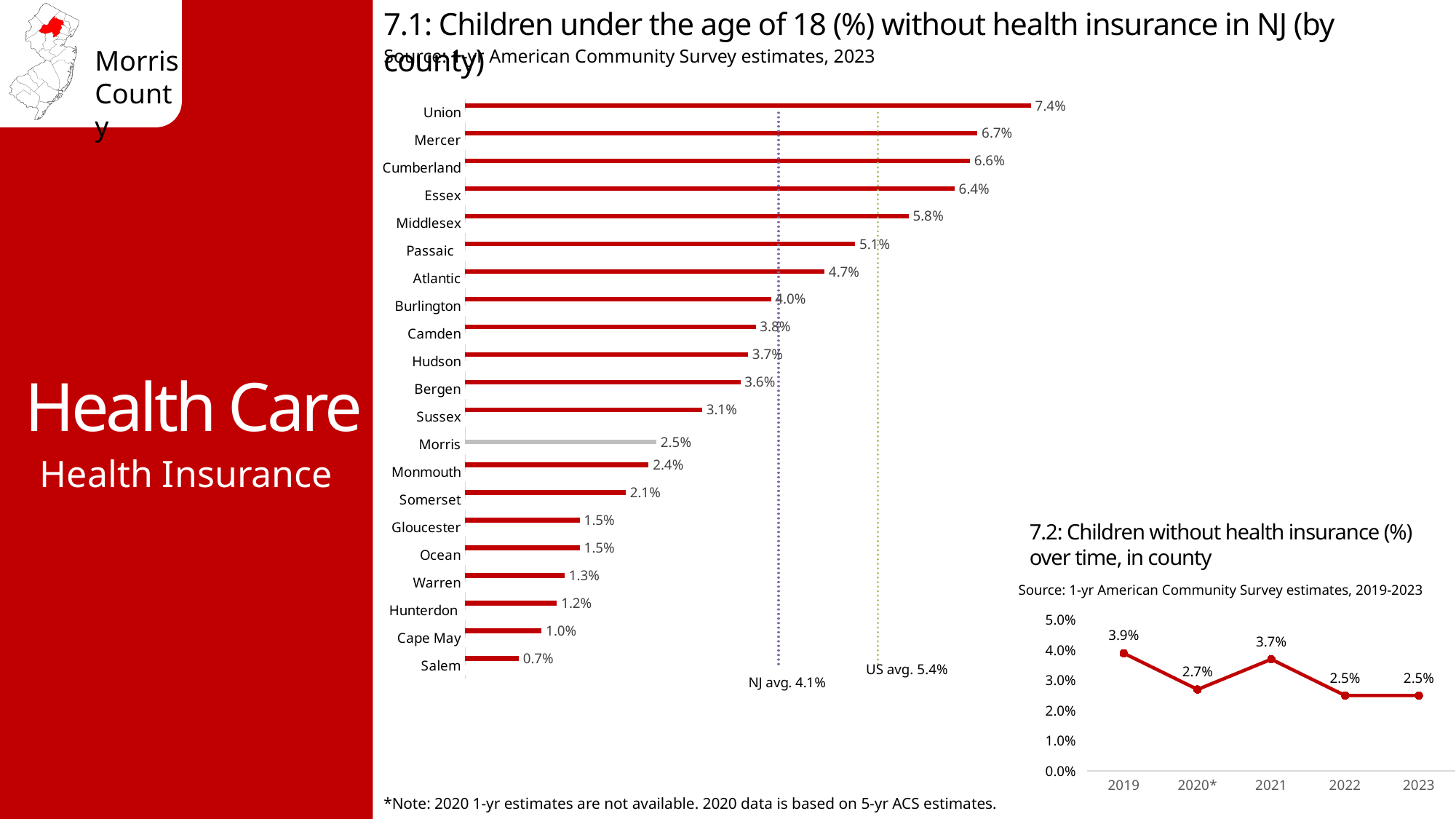
In chart 7.2, what is the difference between the values for 2019 and 2023? 1.4% In chart 7.1, which county has the lowest percentage of children without health insurance? Salem In chart 7.1, what is the difference between the values for Union and Salem? 6.7% In chart 7.1, how many counties are shown? 21 In chart 7.2, what is the value for 2021? 3.7% In chart 7.2, which year has the highest value? 2019 In chart 7.1, what is the NJ average shown by the dotted line? 4.1% In chart 7.1, which county has a larger value, Essex or Middlesex? Essex What kind of chart is chart 7.2 (children without health insurance over time)? Line chart In chart 7.1, which county has the highest percentage of children without health insurance? Union In chart 7.1, what is the value for Passaic? 5.1% In chart 7.1 (children under 18 without health insurance by county), what is the value for Morris? 2.5%